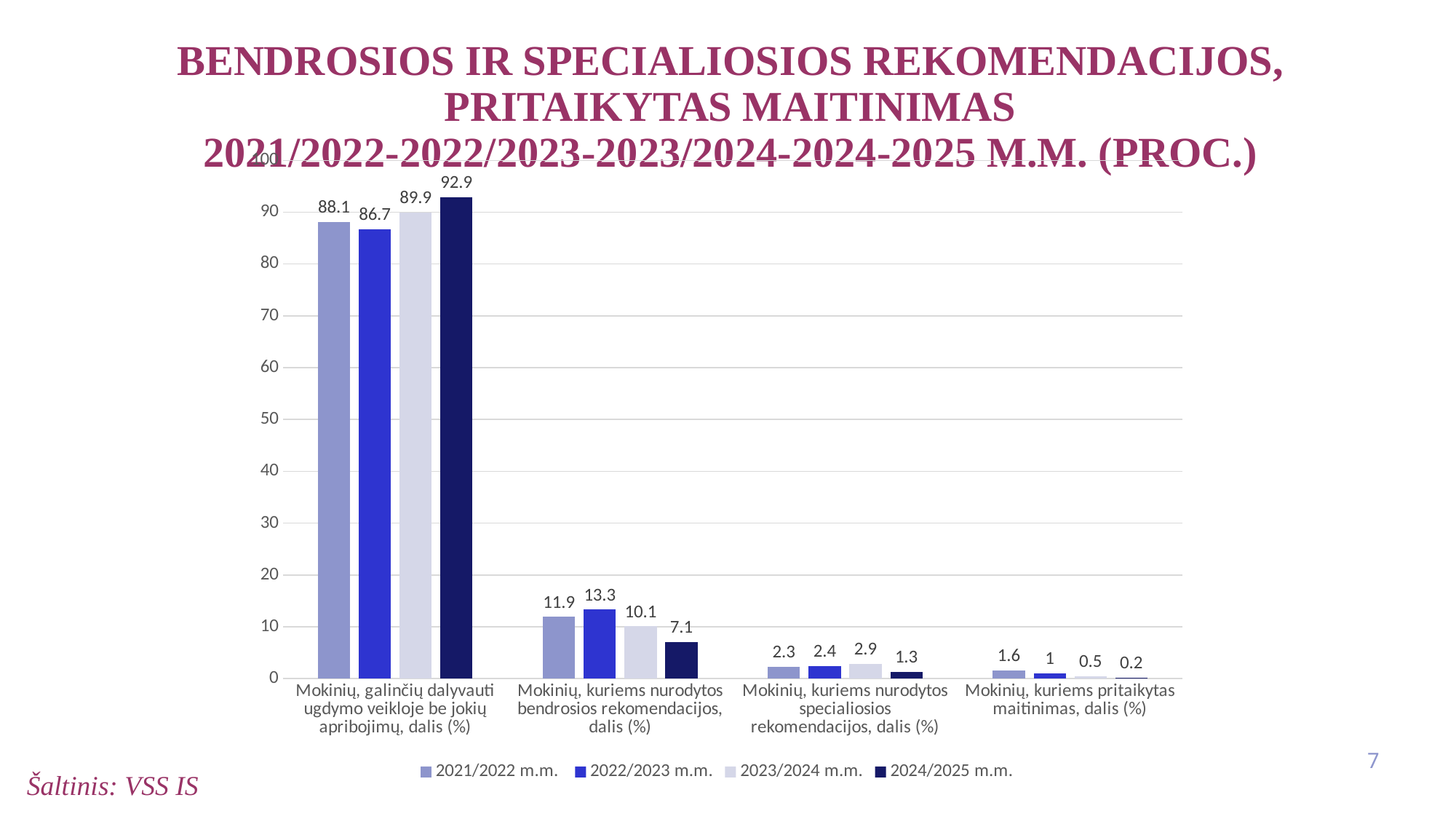
How many categories are shown on the x axis of the chart? 4 Which school year has the highest value in the category "Mokinių, galinčių dalyvauti ugdymo veikloje be jokių apribojimų, dalis (%)"? 2024/2025 m.m. What is the value for 2024/2025 m.m. in the category "Mokinių, galinčių dalyvauti ugdymo veikloje be jokių apribojimų, dalis (%)"? 92.9 How many series does the legend list? 4 Which school year has the lowest value in the category "Mokinių, kuriems nurodytos bendrosios rekomendacijos, dalis (%)"? 2024/2025 m.m. What kind of chart is shown on the slide? Bar chart What is the value for 2023/2024 m.m. in the category "Mokinių, kuriems nurodytos specialiosios rekomendacijos, dalis (%)"? 2.9 Do the values for "Mokinių, kuriems pritaikytas maitinimas, dalis (%)" rise or fall from 2021/2022 m.m. to 2024/2025 m.m.? Fall In the category "Mokinių, kuriems nurodytos bendrosios rekomendacijos, dalis (%)", which is larger: the 2021/2022 m.m. value or the 2023/2024 m.m. value? 2021/2022 m.m. What is the difference between the 2024/2025 m.m. and 2021/2022 m.m. values in the category "Mokinių, galinčių dalyvauti ugdymo veikloje be jokių apribojimų, dalis (%)"? 4.8 What is the value for 2022/2023 m.m. in the category "Mokinių, kuriems nurodytos bendrosios rekomendacijos, dalis (%)"? 13.3 What is the value for 2021/2022 m.m. in the category "Mokinių, kuriems pritaikytas maitinimas, dalis (%)"? 1.6